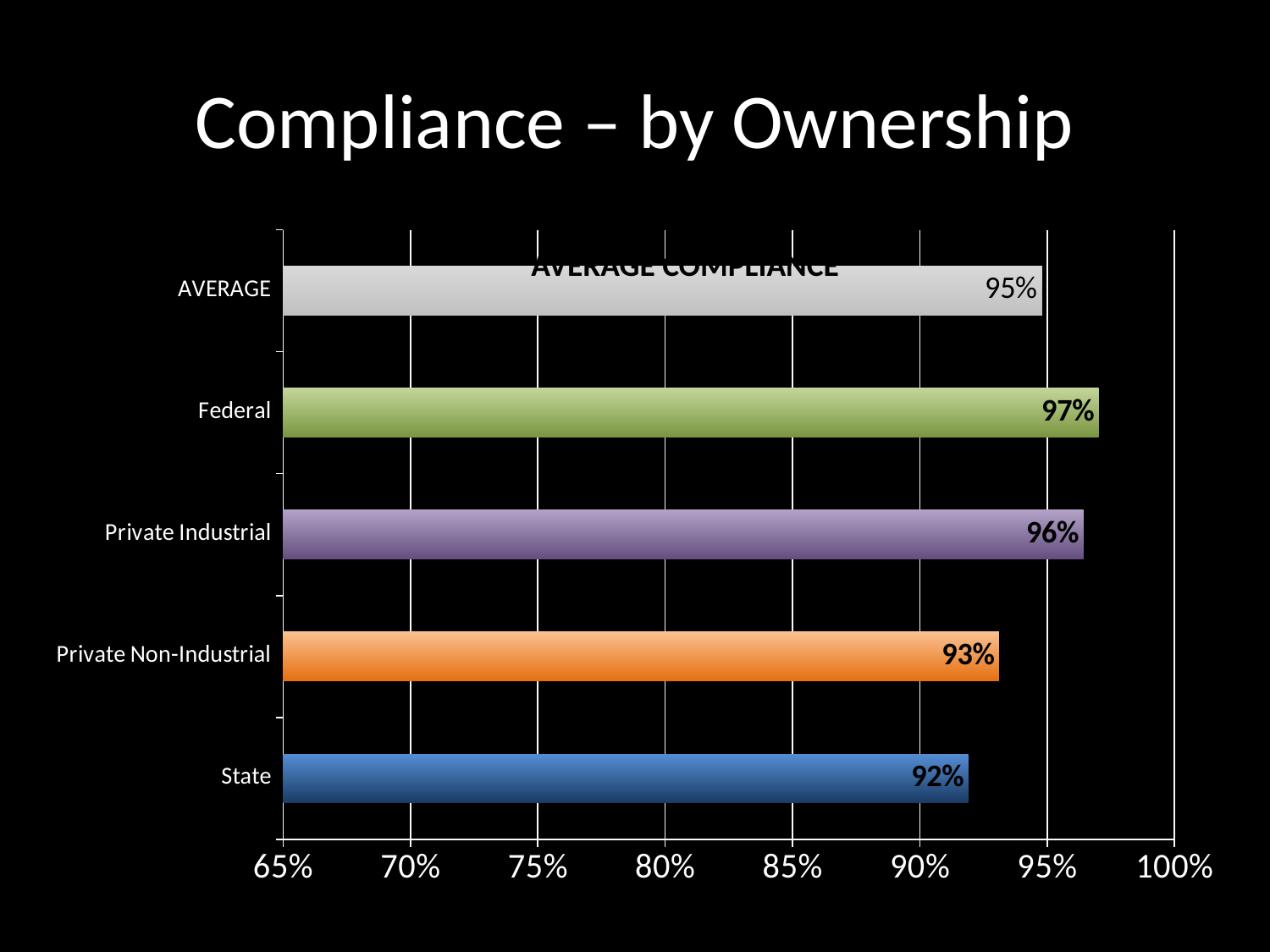
What is the difference between the Federal and State compliance values? 5% Which ownership category has the highest compliance? Federal What is the value shown for AVERAGE? 95% How many bars are shown in the chart? 5 What kind of chart is shown on the slide? Bar chart Which is larger, the compliance for Private Industrial or Private Non-Industrial? Private Industrial Is the value for State greater or less than 90%? greater What is the compliance value for Federal? 97% What is the compliance value for State? 92% Which ownership category has the lowest compliance? State What is the compliance value for Private Non-Industrial? 93% What is the compliance value for Private Industrial? 96%